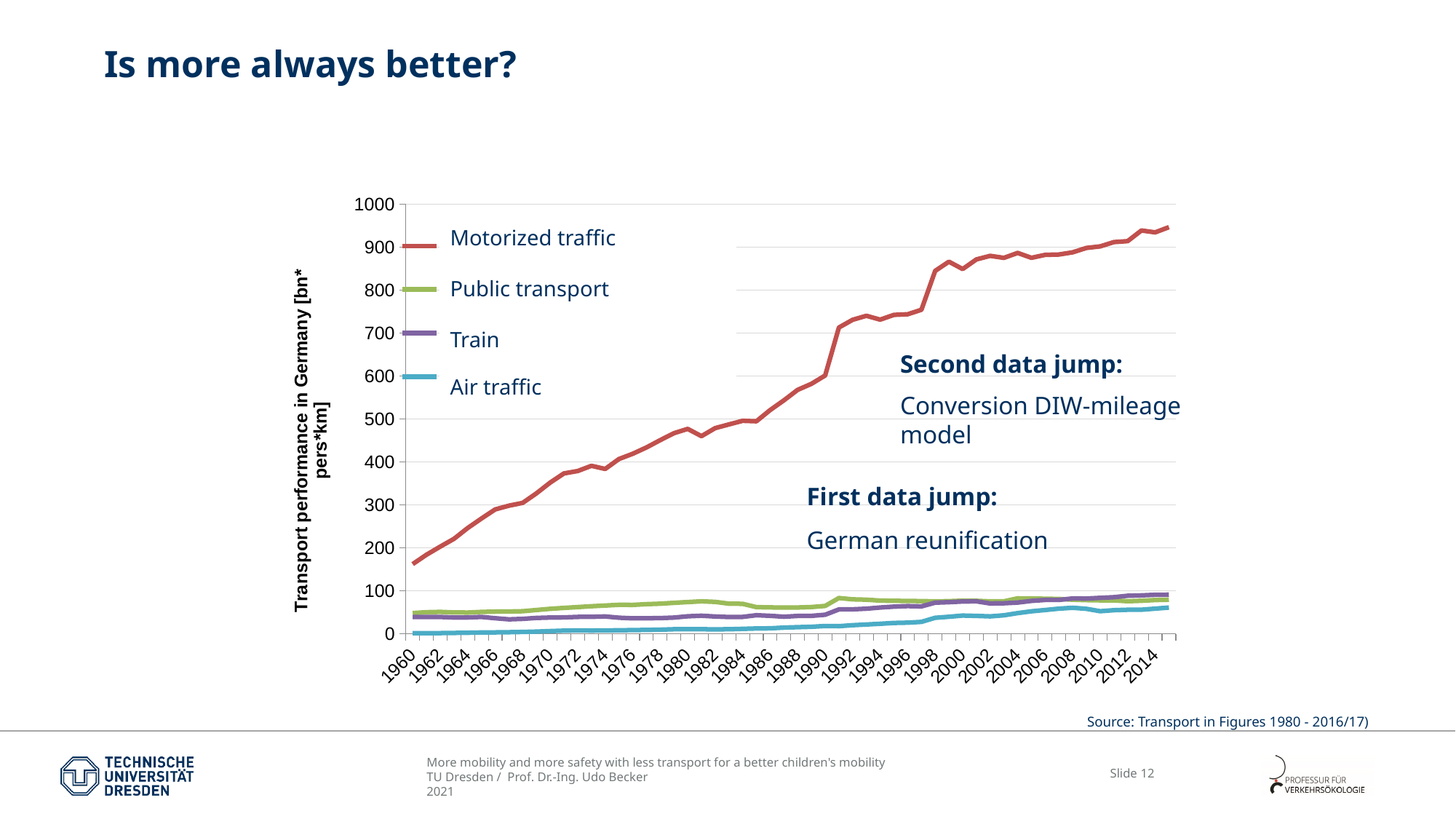
Is the value for Air traffic in 1960 greater or less than 100? less Which is larger in 2014, Motorized traffic or Public transport? Motorized traffic Is the value for Motorized traffic in 1960 greater or less than 200? less Which series has the highest values throughout the chart? Motorized traffic Does the Motorized traffic series rise or fall from 1960 to 2014? Rise How many series does the chart legend list? 4 Which series has the lowest value in 1960? Air traffic What kind of chart is shown on the slide? Line chart Is the value for Motorized traffic in 2014 greater or less than 900? greater What is the label of the vertical axis? Transport performance in Germany [bn* pers*km] Which is larger in 1960, Train or Air traffic? Train